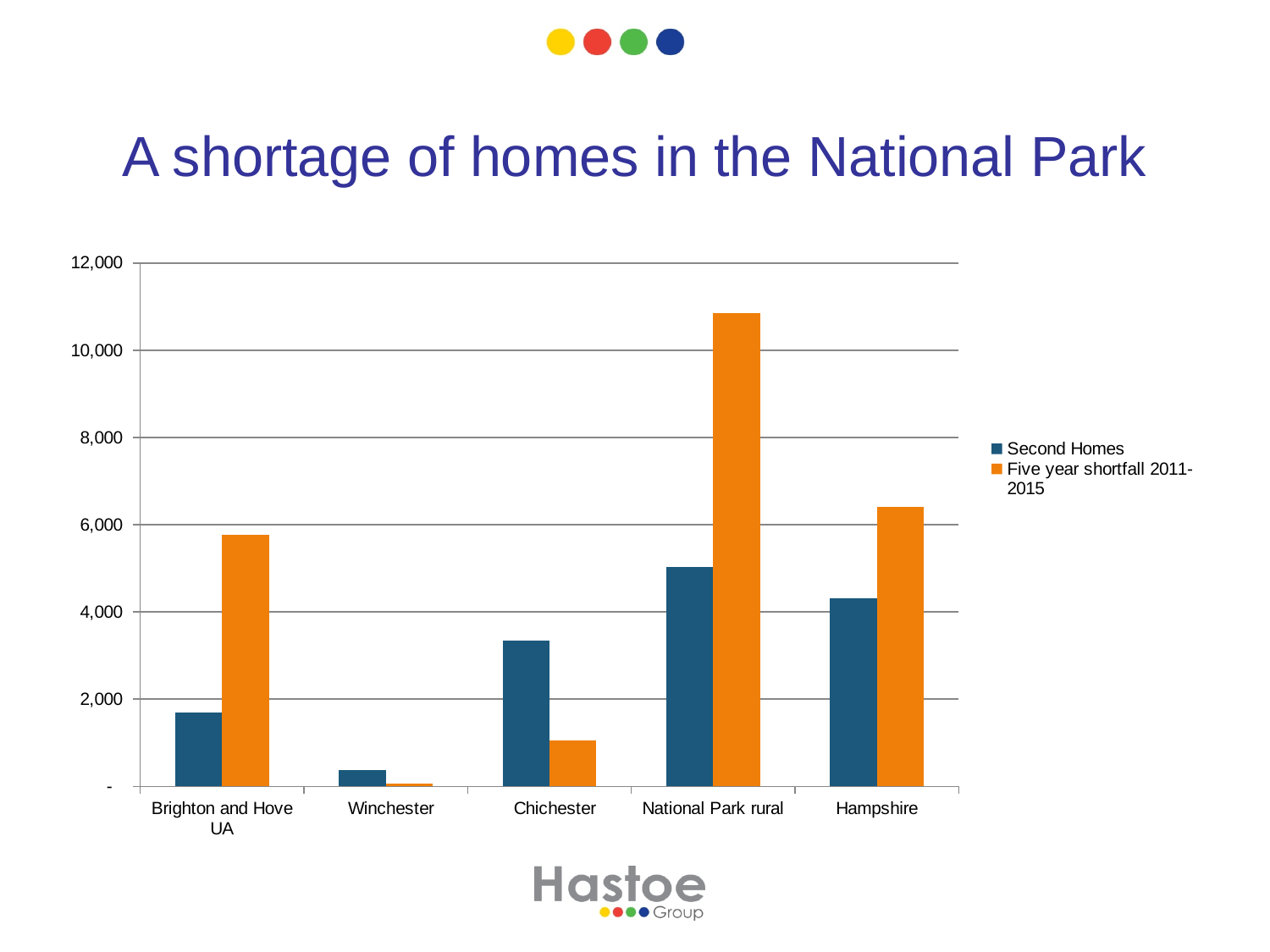
Is the Second Homes value for Chichester greater or less than 4,000? less Which is larger: the Five year shortfall 2011-2015 for Hampshire or for Brighton and Hove UA? Hampshire Which category has the lowest Second Homes value? Winchester For Chichester, which is larger: Second Homes or Five year shortfall 2011-2015? Second Homes Is the Five year shortfall 2011-2015 value for National Park rural greater or less than 10,000? greater How many series does the legend list? 2 Which category has the lowest Five year shortfall 2011-2015 value? Winchester What kind of chart is shown on the slide? bar chart Which category has the highest Second Homes value? National Park rural Which category has the highest Five year shortfall 2011-2015 value? National Park rural What is the title of the slide containing the chart? A shortage of homes in the National Park How many categories are shown on the x axis? 5